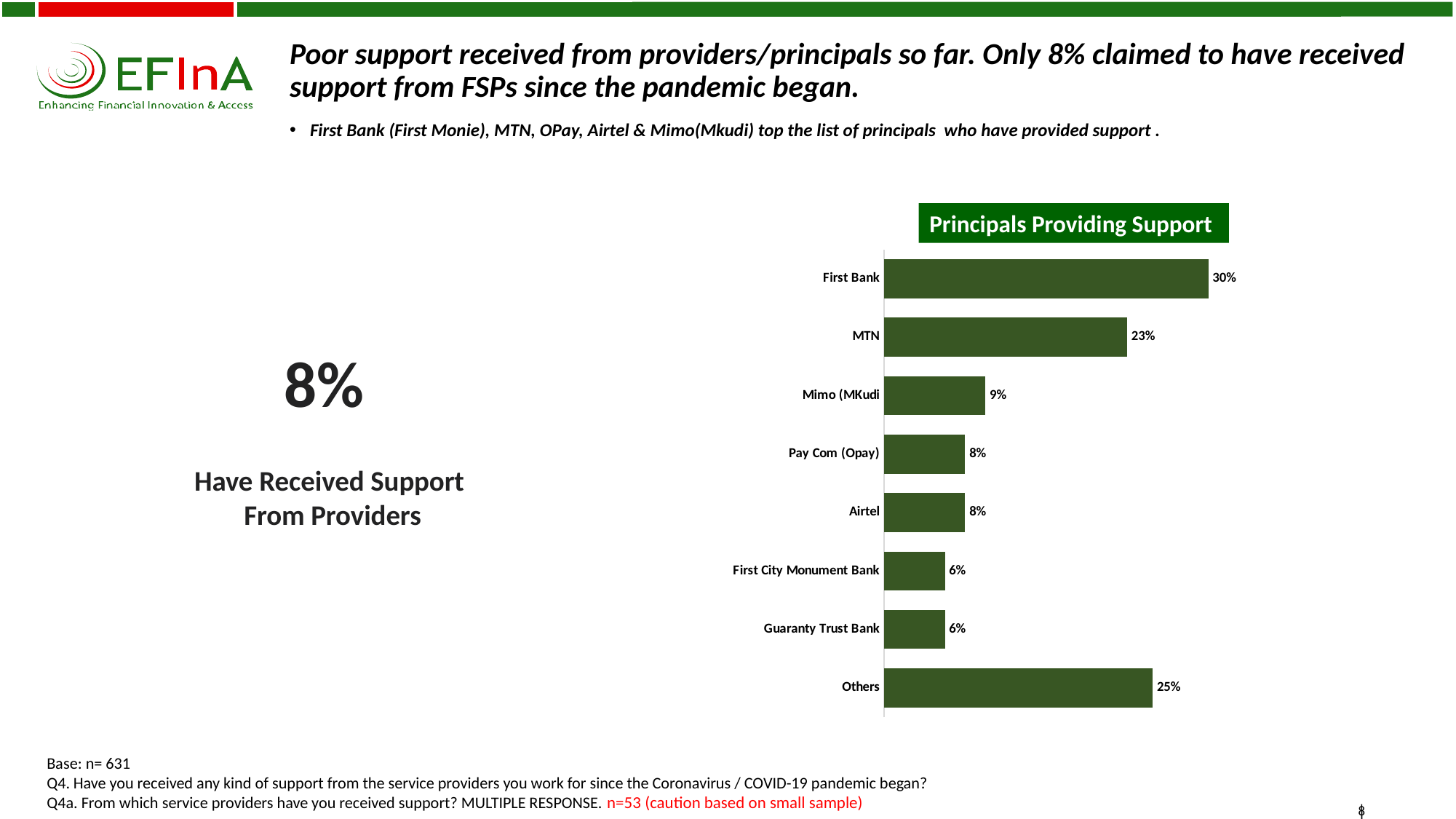
Which is larger in the Principals Providing Support chart, the value for MTN or the value for Others? Others What is the value for MTN in the Principals Providing Support chart? 23% What is the value for Guaranty Trust Bank in the Principals Providing Support chart? 6% What is the value for Others in the Principals Providing Support chart? 25% How many categories are shown in the Principals Providing Support chart? 8 What is the value for First Bank in the Principals Providing Support chart? 30% What is the difference between the values for First Bank and MTN in the Principals Providing Support chart? 7% Which is larger in the Principals Providing Support chart, the value for Mimo (MKudi or the value for First City Monument Bank? Mimo (MKudi What is the difference between the values for Airtel and Guaranty Trust Bank in the Principals Providing Support chart? 2% What is the title of the chart on the slide? Principals Providing Support What kind of chart is the Principals Providing Support chart? Bar chart Which category has the highest value in the Principals Providing Support chart? First Bank